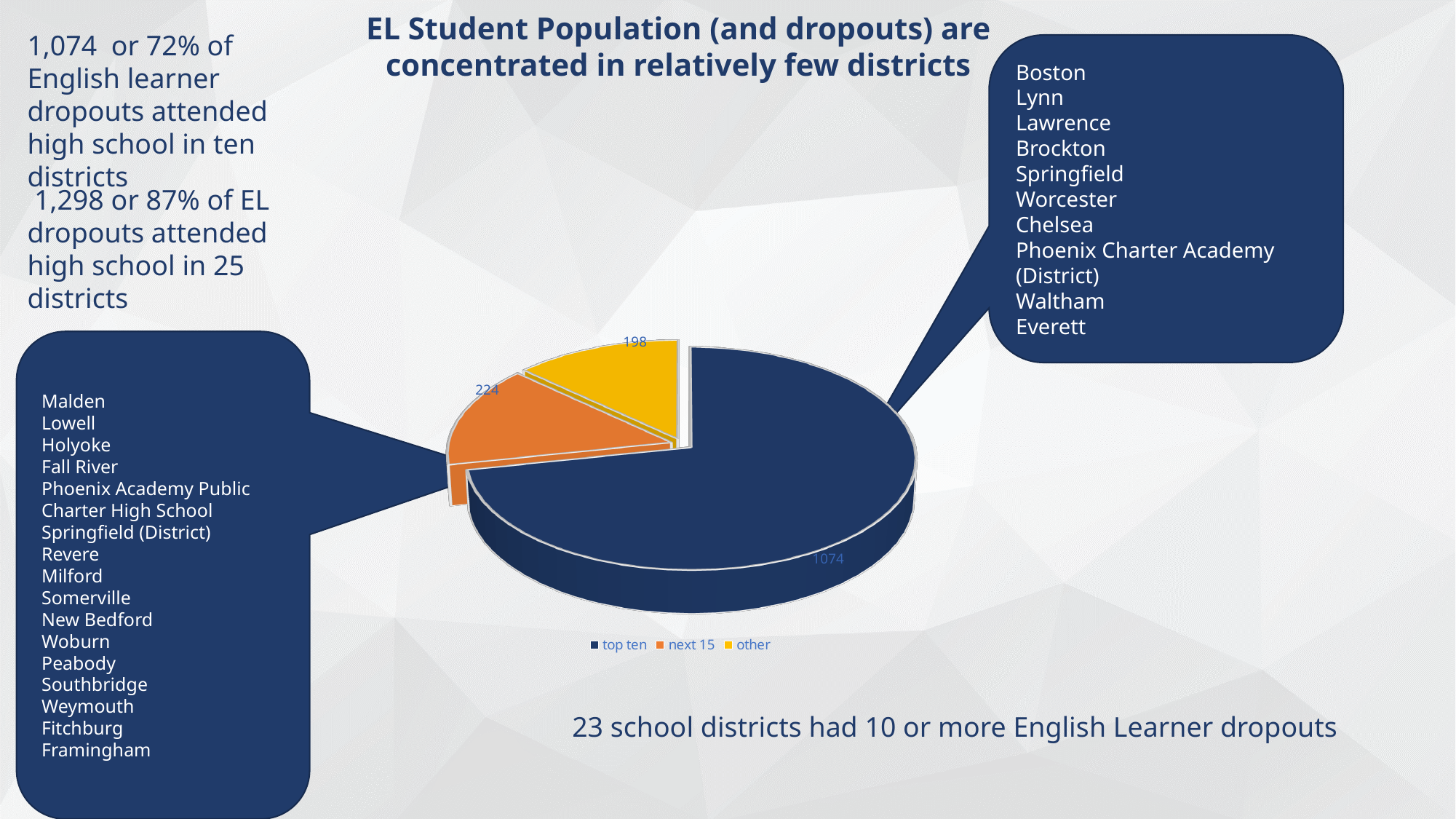
What colour is the 'other' slice in the pie chart? yellow What is the value of the 'next 15' slice in the pie chart? 224 How many slices does the pie chart have? 3 How many entries does the legend of the pie chart list? 3 What is the difference between the 'next 15' slice and the 'other' slice? 26 Which slice of the pie chart is the smallest? other What is the value of the 'top ten' slice in the pie chart? 1074 Which slice of the pie chart is the largest? top ten What is the value of the 'other' slice in the pie chart? 198 What kind of chart is shown on the slide? pie chart What is the difference between the 'top ten' slice and the 'next 15' slice? 850 Which is larger in the pie chart, 'next 15' or 'other'? next 15